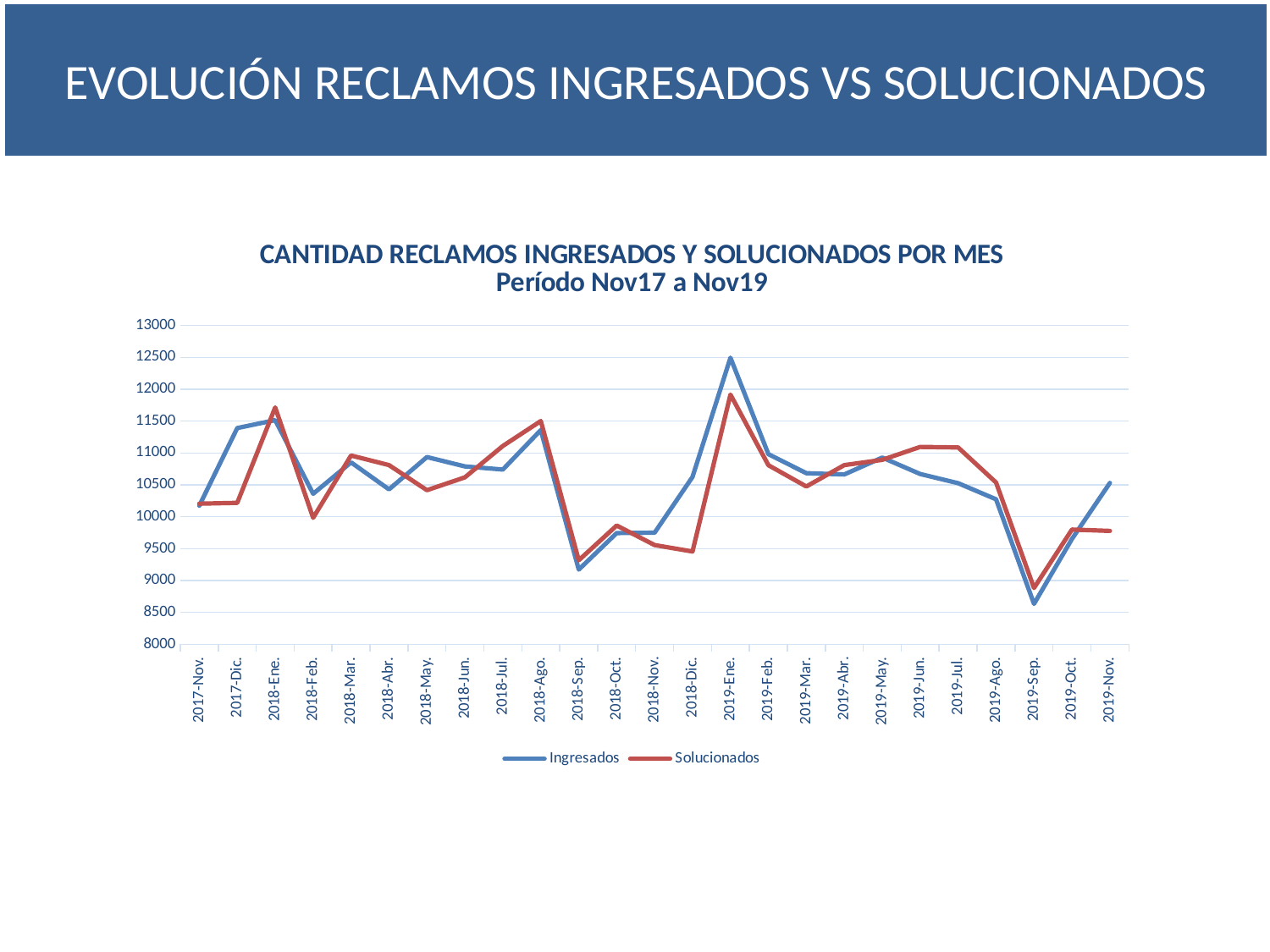
Is the Solucionados value for 2018-Feb. greater or less than 10500? less What kind of chart is shown on the slide? Line chart Is the Ingresados value for 2019-Sep. greater or less than 9000? less How many series does the legend list? 2 In which month does the Solucionados series reach its highest value? 2019-Ene. In which month does the Ingresados series reach its highest value? 2019-Ene. How many months are plotted along the x axis? 25 In which month does the Ingresados series reach its lowest value? 2019-Sep. Do the Ingresados values rise or fall from 2019-Ene. to 2019-Sep.? fall Is the Ingresados value for 2019-Ene. greater or less than 12000? greater Which colour is used for the Solucionados line? Red In 2017-Dic., which series has the larger value, Ingresados or Solucionados? Ingresados